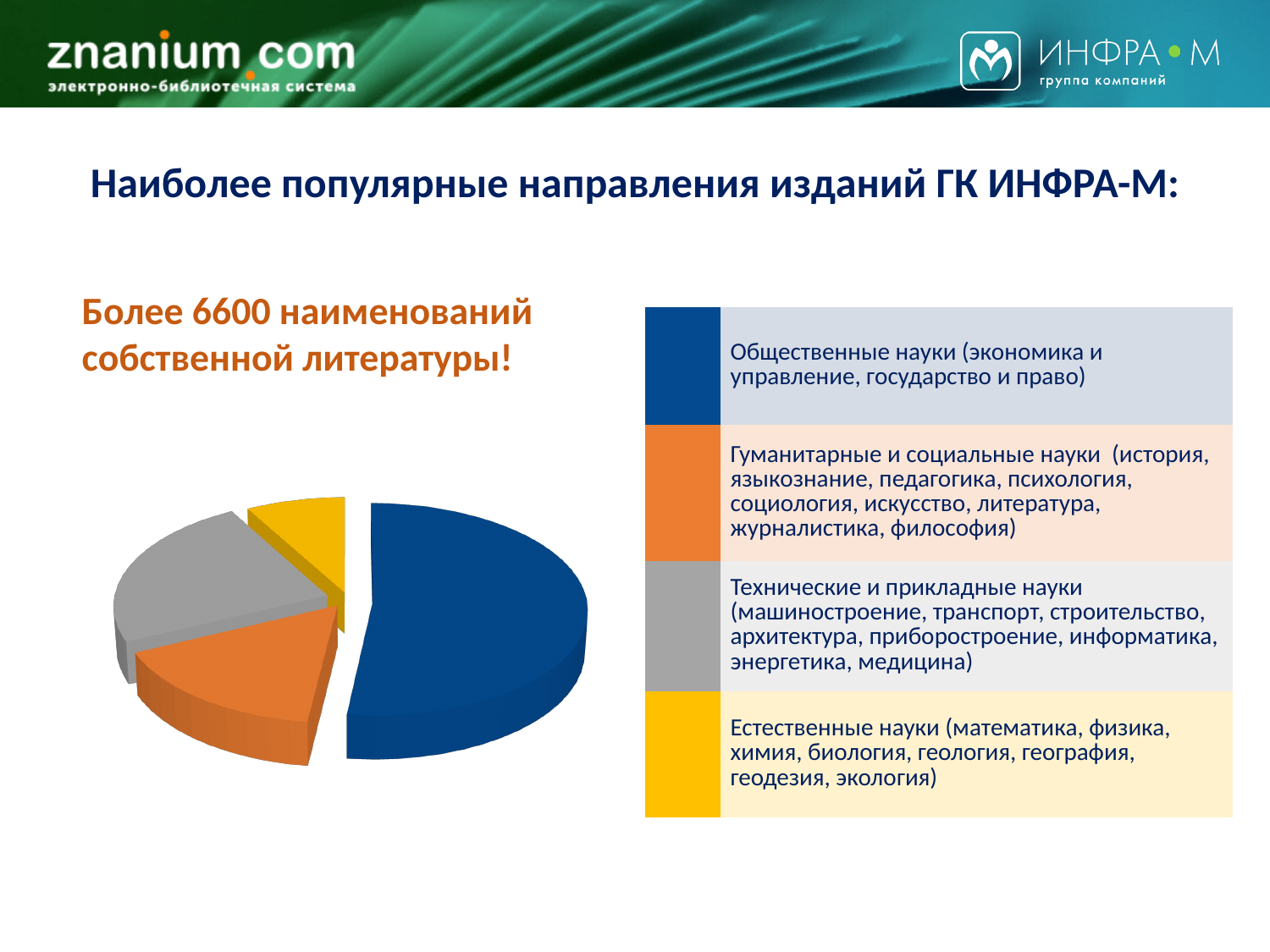
Which category has the largest slice of the pie chart? Общественные науки (экономика и управление, государство и право) What colour represents Общественные науки in the pie chart? Blue Which slice is larger: Общественные науки or Гуманитарные и социальные науки? Общественные науки Which category has the smallest slice of the pie chart? Естественные науки (математика, физика, химия, биология, геология, география, геодезия, экология) Which slice is larger: Технические и прикладные науки or Естественные науки? Технические и прикладные науки What kind of chart is shown on the slide? Pie chart How many slices does the pie chart have? 4 Which slice is larger: Общественные науки or Естественные науки? Общественные науки What colour represents Технические и прикладные науки in the pie chart? Gray